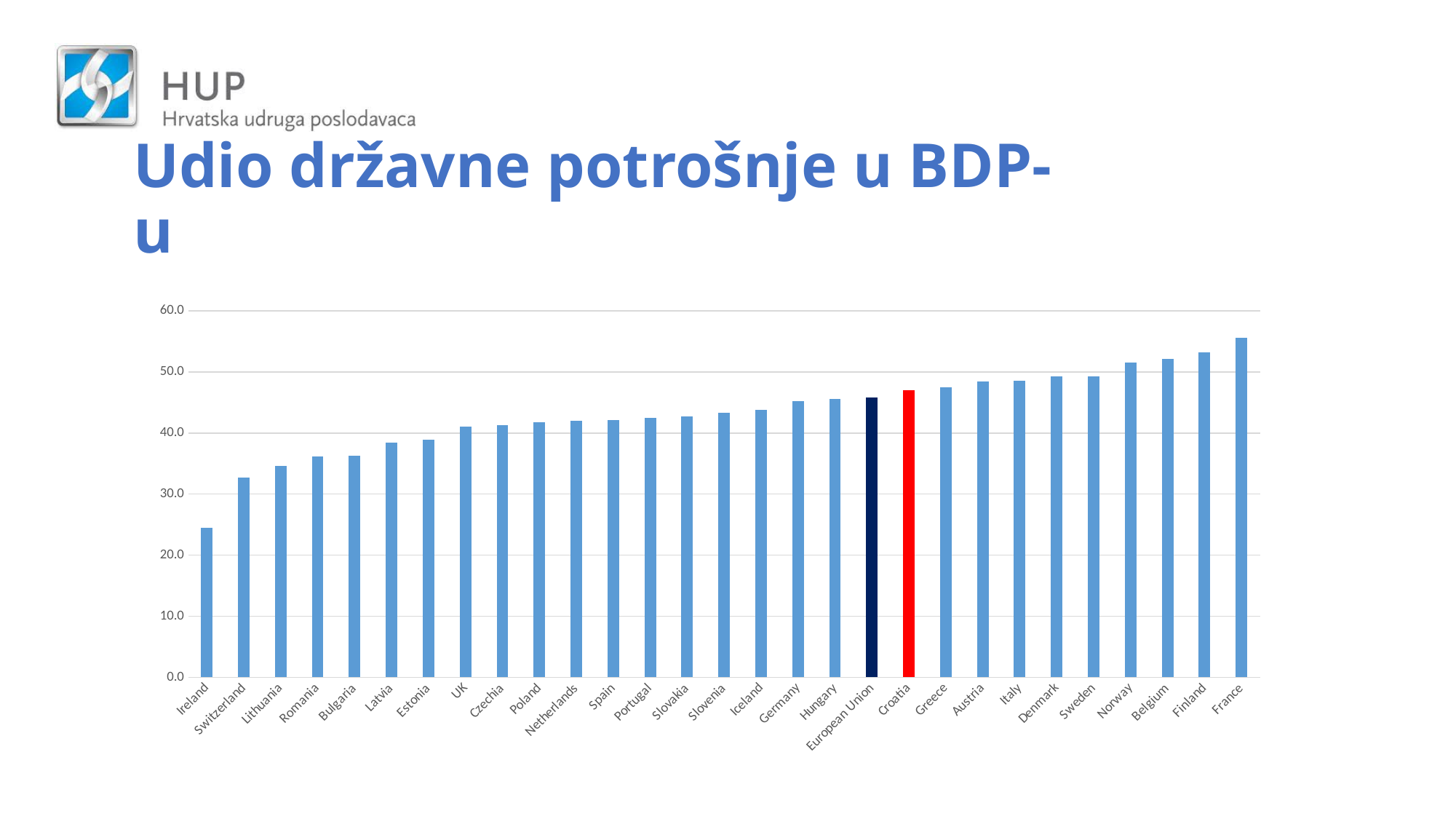
Is the value for France greater or less than 50.0? greater Do the values rise or fall moving from left to right along the x axis? rise Which country has the lowest value on the chart? Ireland Is the value for Croatia greater or less than 40.0? greater Is the value for Ireland greater or less than 30.0? less Which is larger, the value for Denmark or the value for Germany? Denmark Which country's bar is coloured red on the chart? Croatia Which country has the highest share of government spending in GDP on the chart? France What kind of chart is shown on the slide? bar chart How many categories (bars) are shown on the chart? 29